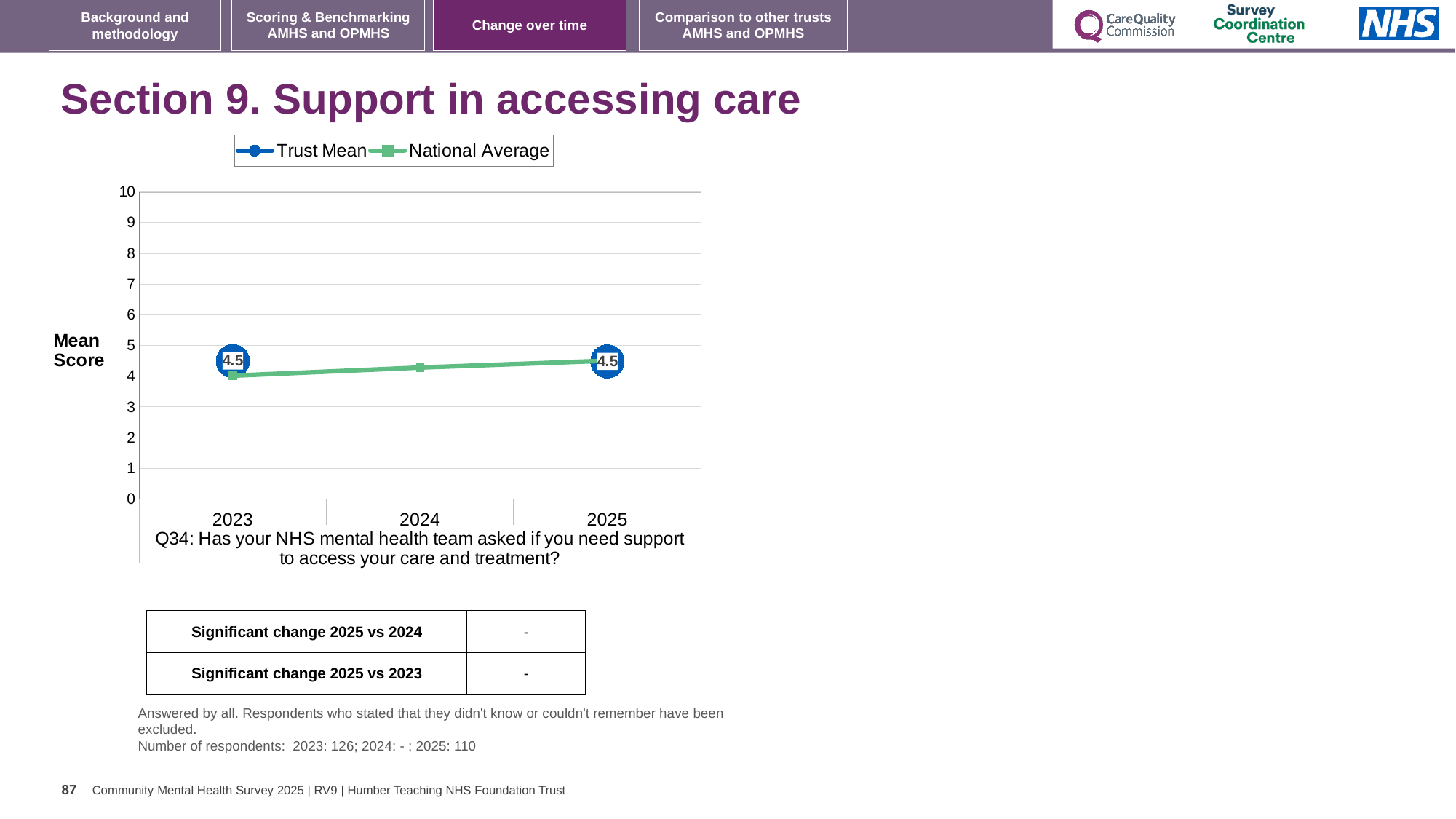
Which series is shown in green in the chart legend? National Average What is the Trust Mean score for 2025? 4.5 What is the label on the y axis of the chart? Mean Score What is the Trust Mean score for 2023? 4.5 Is the National Average value for 2023 greater or less than 5? less What is the difference between the Trust Mean score in 2025 and in 2023? 0 Is the Trust Mean value for 2025 greater or less than 4? greater Does the National Average rise or fall from 2023 to 2025? rise Is the National Average value for 2024 greater or less than 5? less How many series does the chart legend list? 2 What kind of chart is shown on the slide? line chart How many years are shown on the x axis of the chart? 3